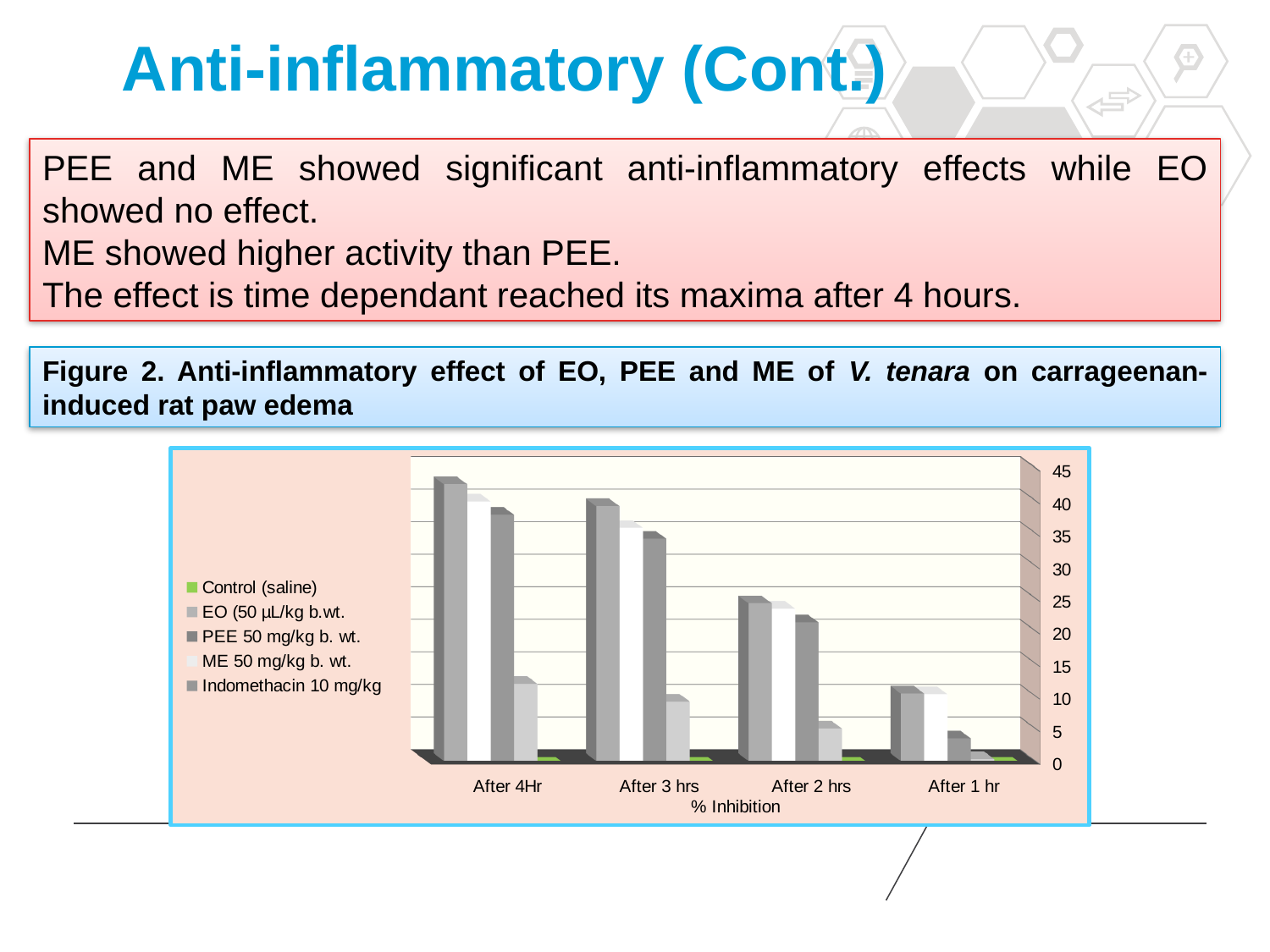
Is the value for EO (50 µL/kg b.wt. at After 2 hrs greater or less than 10? less Is the value for ME 50 mg/kg b. wt. at After 1 hr greater or less than 5? greater Which legend entry is shown in green? Control (saline) Moving left to right along the x axis from After 4Hr to After 1 hr, do the ME 50 mg/kg b. wt. values rise or fall? fall How many time-point categories are shown on the x axis of the chart? 4 Is the value for EO (50 µL/kg b.wt. at After 4Hr greater or less than 15? less What label is printed below the x axis of the chart? % Inhibition At which time point is the ME 50 mg/kg b. wt. value highest? After 4Hr At which time point is the ME 50 mg/kg b. wt. value lowest? After 1 hr How many series does the chart legend list? 5 What kind of chart is shown on the slide? bar chart